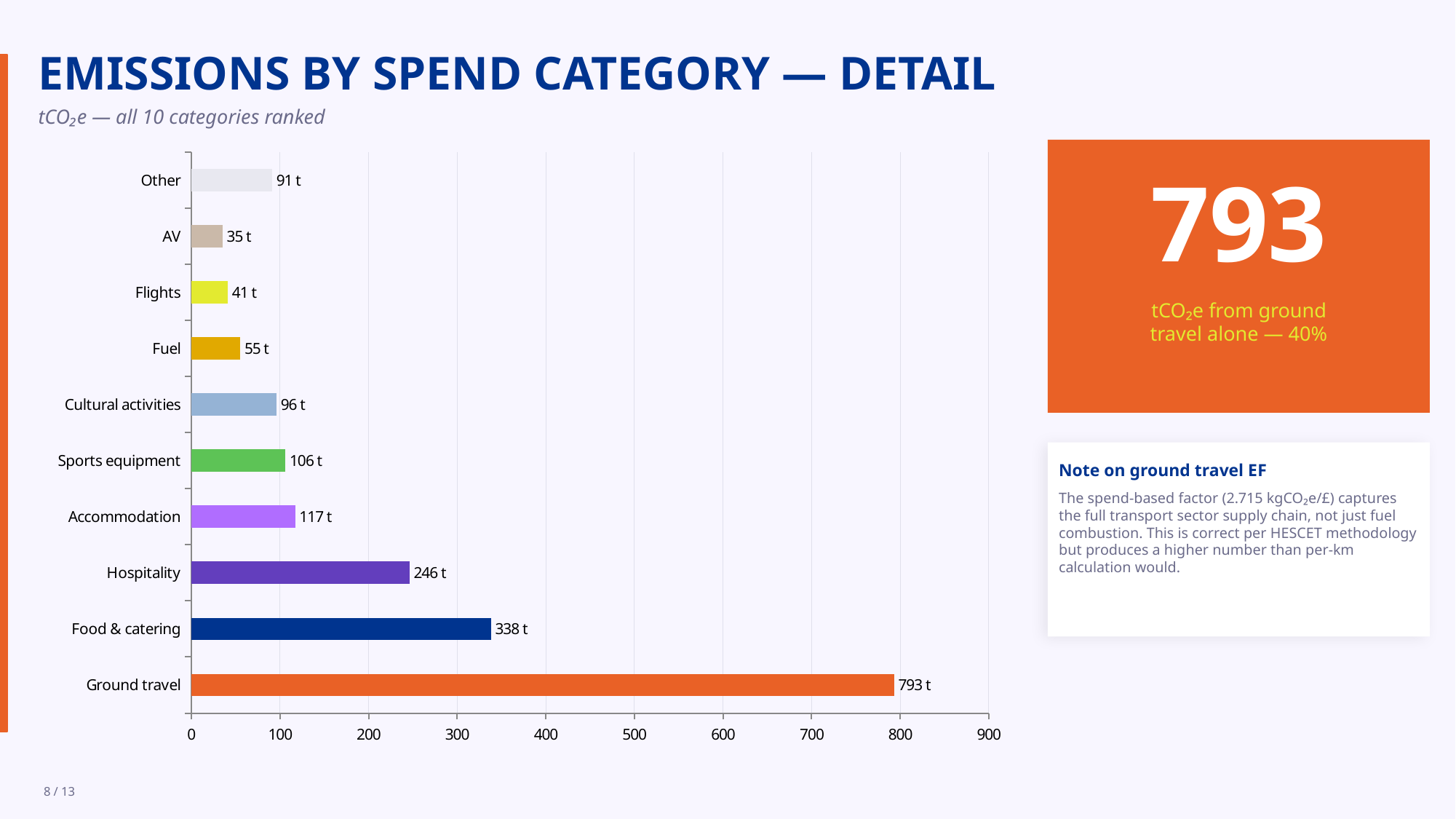
What is the value for Hospitality? 246 t What is the difference between Accommodation and Sports equipment? 11 t What kind of chart is shown on the slide? Bar chart What is the title of the slide? EMISSIONS BY SPEND CATEGORY — DETAIL Is the value for Food & catering greater or less than 300? greater What is the value for Cultural activities? 96 t What is the difference between Food & catering and Hospitality? 92 t What is the value for Ground travel? 793 t Which category has the highest emissions? Ground travel Which is larger, Fuel or Flights? Fuel Which category has the lowest emissions? AV How many categories are shown in the chart? 10